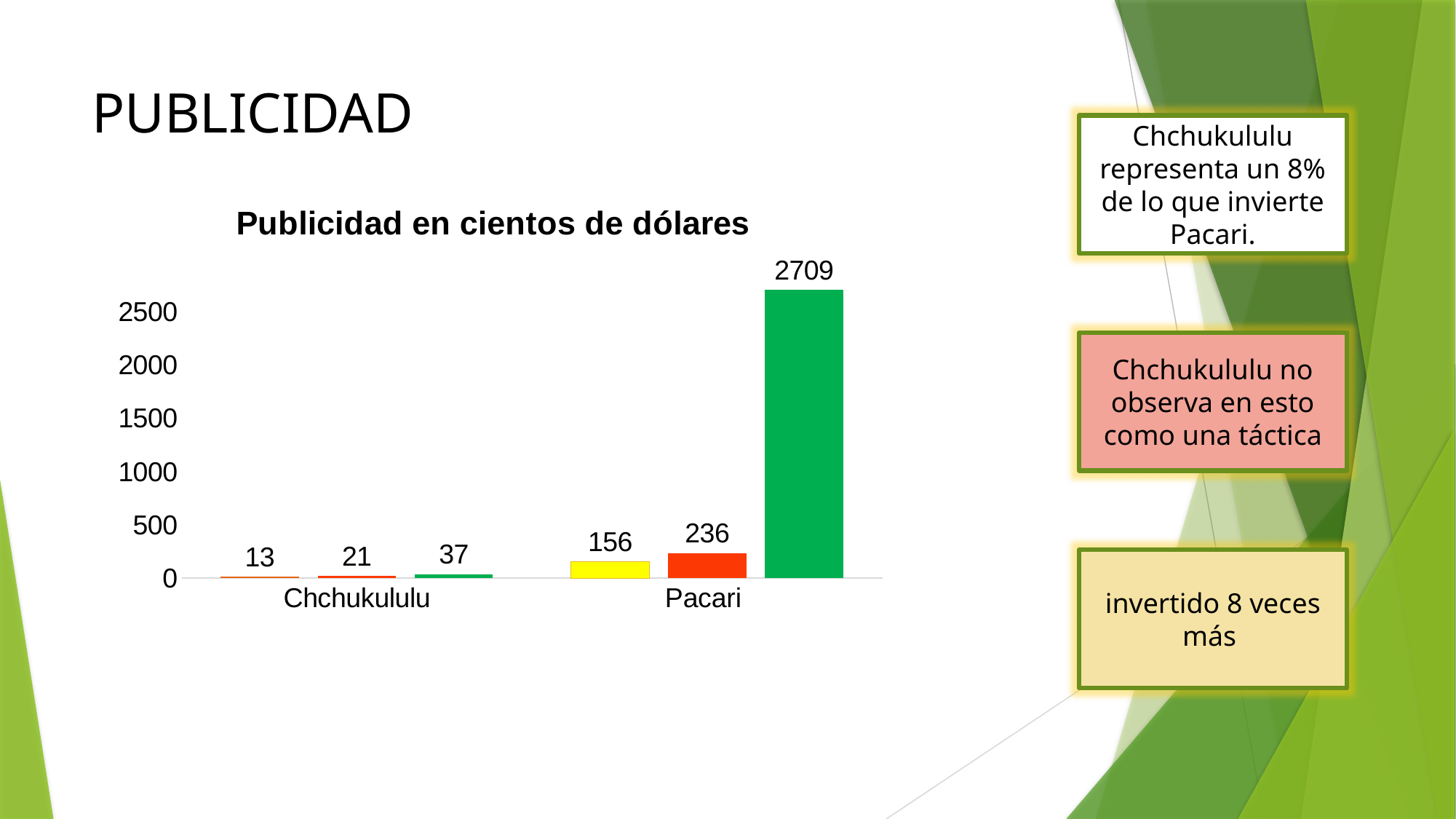
What is the title of the chart? Publicidad en cientos de dólares Is the value of the tallest Pacari bar greater or less than 2500? greater How many bars are plotted in the chart in total? 6 How many categories are shown on the x axis of the chart? 2 What kind of chart is shown on the slide? bar chart What is the value of the first (leftmost) bar for Chchukululu? 13 Which category contains the highest bar in the chart? Pacari What is the smallest value labelled in the chart? 13 What is the value of the red bar for Pacari? 236 What is the difference between the tallest Pacari bar (2709) and the red Pacari bar (236)? 2473 What is the value of the yellow bar for Pacari? 156 What is the value of the tallest bar for Pacari? 2709